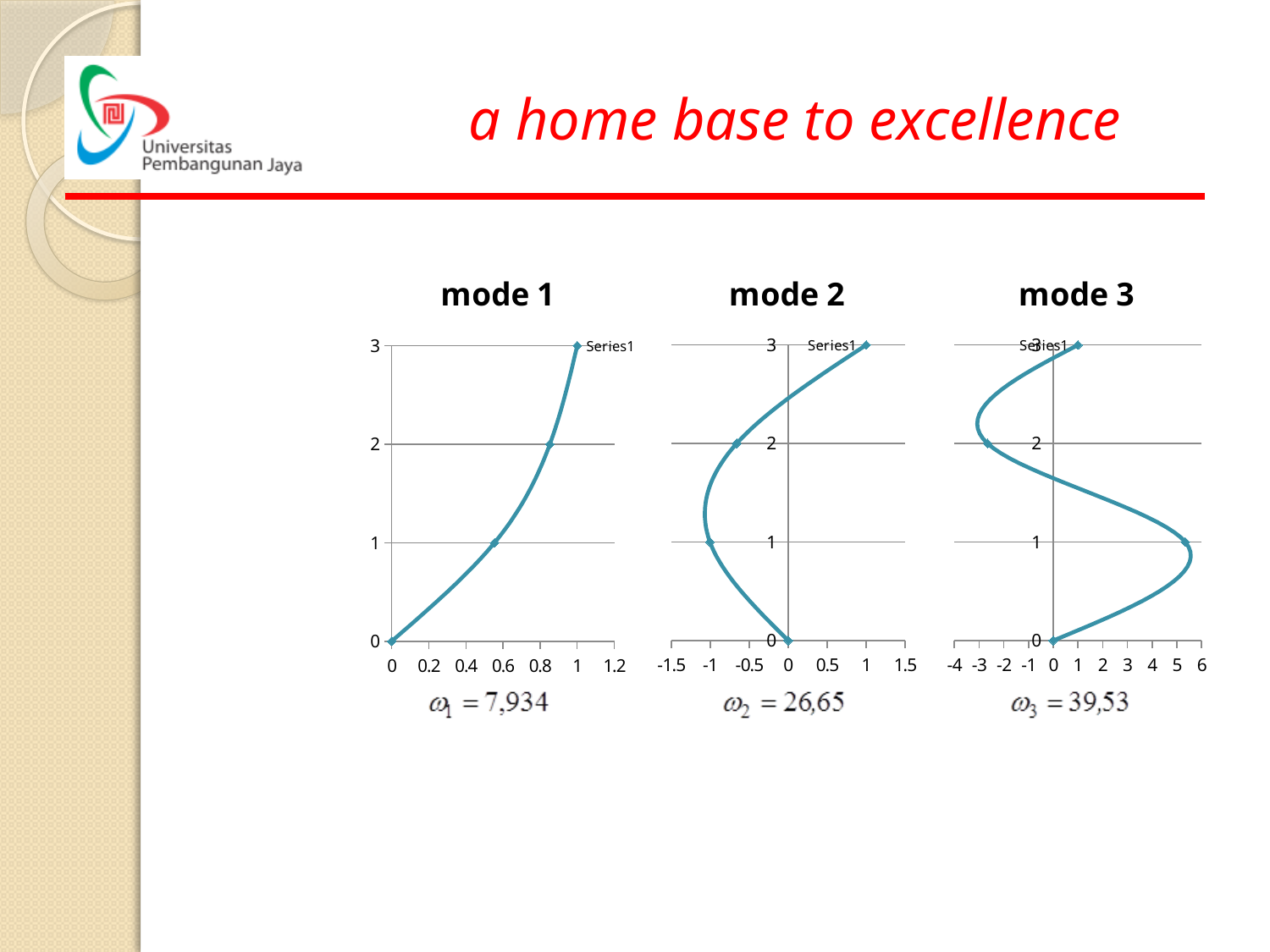
What is the legend entry shown on the "mode 2" chart? Series1 What kind of chart is the "mode 1" chart? line chart How many charts are shown on the slide? 3 In the "mode 3" chart, is the x value of the point at height 1 greater or less than 4? greater In the "mode 2" chart, is the x value of the point at height 1 greater or less than -0.5? less How many series does the legend of the "mode 1" chart list? 1 In the "mode 1" chart, is the x value of the point at height 1 greater or less than 0.8? less In the "mode 1" chart, does the x value increase or decrease as the height goes from 0 to 3? increase What is the highest tick value on the x axis of the "mode 3" chart? 6 How many data points are plotted in the "mode 2" chart? 4 In the "mode 1" chart, what is the x value of the point at height 3? 1